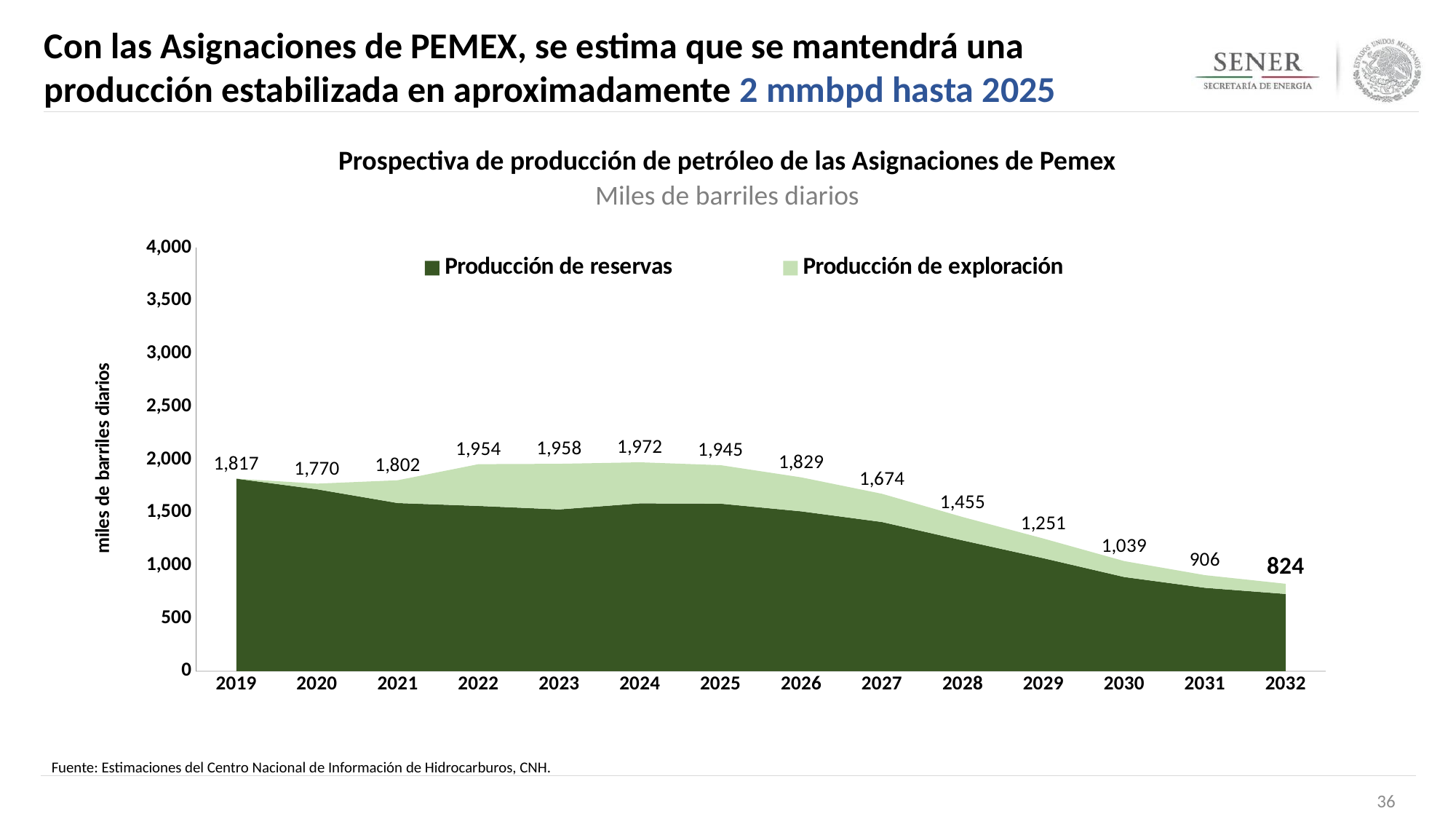
Is the value of Producción de reservas in 2032 greater or less than 1,000? less What is the total production value shown for 2032? 824 How many series does the legend list? 2 What kind of chart is shown on the slide? Stacked area chart Which year has the highest total production value? 2024 Which year has the lowest total production value? 2032 How many years are shown on the x axis? 14 Which year has a larger total production, 2022 or 2029? 2022 What is the total production value shown for 2028? 1,455 What is the total production value shown for 2019? 1,817 Is the value of Producción de reservas in 2019 greater or less than 1,500? greater What is the difference between the total production in 2019 and in 2032? 993